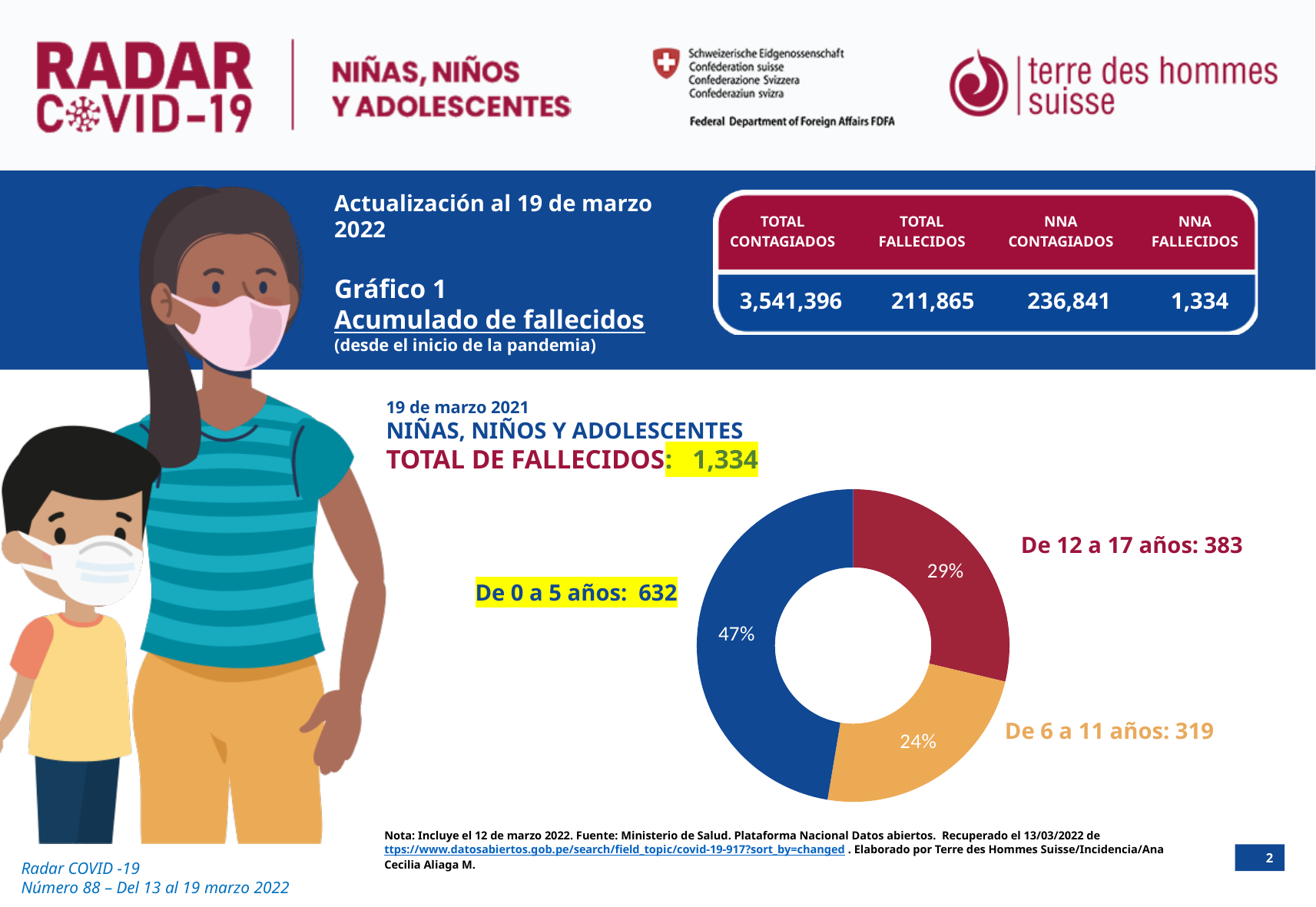
Which age group has the highest number of deaths in the donut chart? De 0 a 5 años What percentage of the donut chart corresponds to the group 'De 0 a 5 años'? 47% Which group has more deaths, 'De 12 a 17 años' or 'De 6 a 11 años'? De 12 a 17 años What is the total number of deaths (TOTAL DE FALLECIDOS) shown above the donut chart? 1,334 Which age group has the lowest number of deaths in the donut chart? De 6 a 11 años What is the number of deaths for the group 'De 0 a 5 años'? 632 What is the number of deaths for the group 'De 6 a 11 años'? 319 What is the number of deaths for the group 'De 12 a 17 años'? 383 What percentage of the donut chart corresponds to the group 'De 6 a 11 años'? 24% What is the difference in deaths between the group 'De 0 a 5 años' and the group 'De 12 a 17 años'? 249 What kind of chart is shown on the slide? Donut (pie) chart How many age groups does the donut chart show? 3